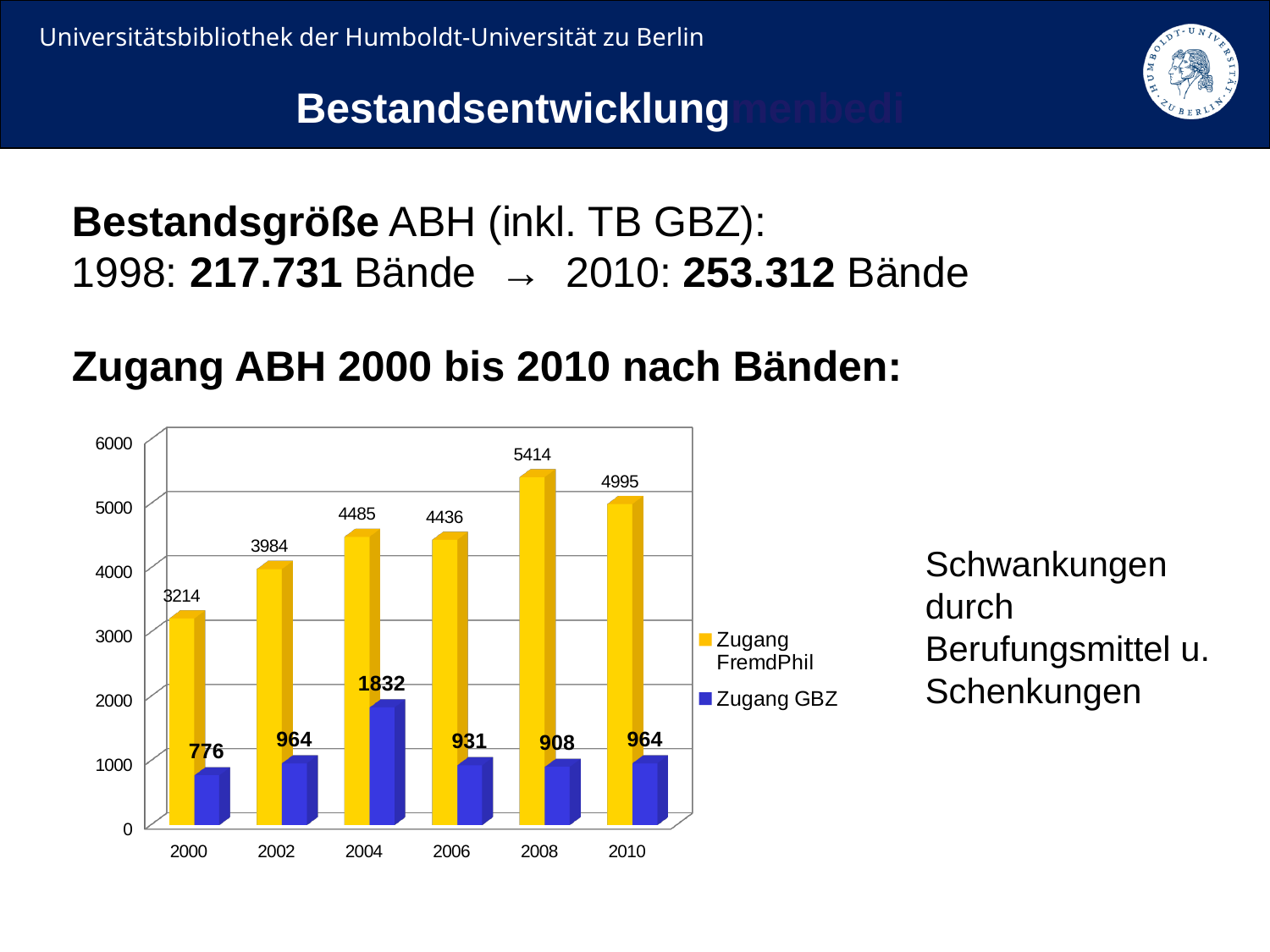
What is the value for Zugang FremdPhil in 2008? 5414 What is the value for Zugang GBZ in 2004? 1832 In which year is Zugang FremdPhil highest? 2008 Is the value for Zugang GBZ in 2004 greater or less than 1000? greater How many series does the legend list? 2 Which colour represents Zugang GBZ in the chart? blue What is the difference between Zugang FremdPhil in 2010 and in 2000? 1781 What kind of chart is shown? bar chart In which year is Zugang GBZ lowest? 2000 What is the value for Zugang FremdPhil in 2000? 3214 Which is larger: Zugang FremdPhil in 2004 or in 2006? 2004 How many years are shown on the x axis? 6